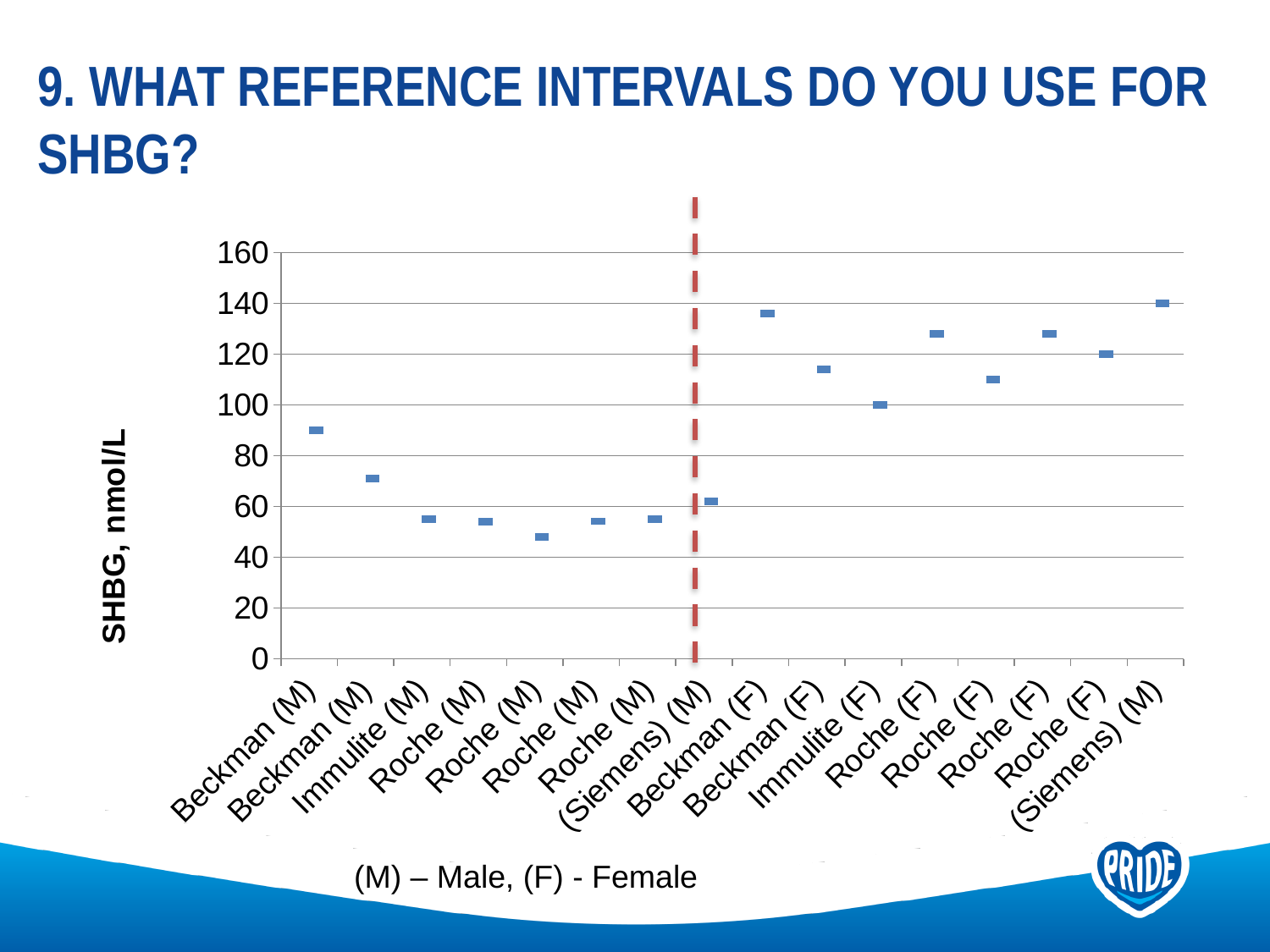
How many categories are labelled Roche (M)? 4 How many categories are labelled Roche (F)? 4 What is the title of the chart's vertical axis? SHBG, nmol/L Is the value for the first (Siemens) (M) category, just left of the dashed line, greater or less than 80? less Which has the larger value, the first Beckman (M) category or the first Beckman (F) category? Beckman (F) What is the highest value shown on the vertical axis? 160 How many categories are plotted along the x axis? 16 Is the value for the first Beckman (F) category greater or less than 120? greater Which has the larger value, Immulite (M) or Immulite (F)? Immulite (F) Is the value for the first Beckman (M) category greater or less than 80? greater What is the value for Immulite (F)? 100